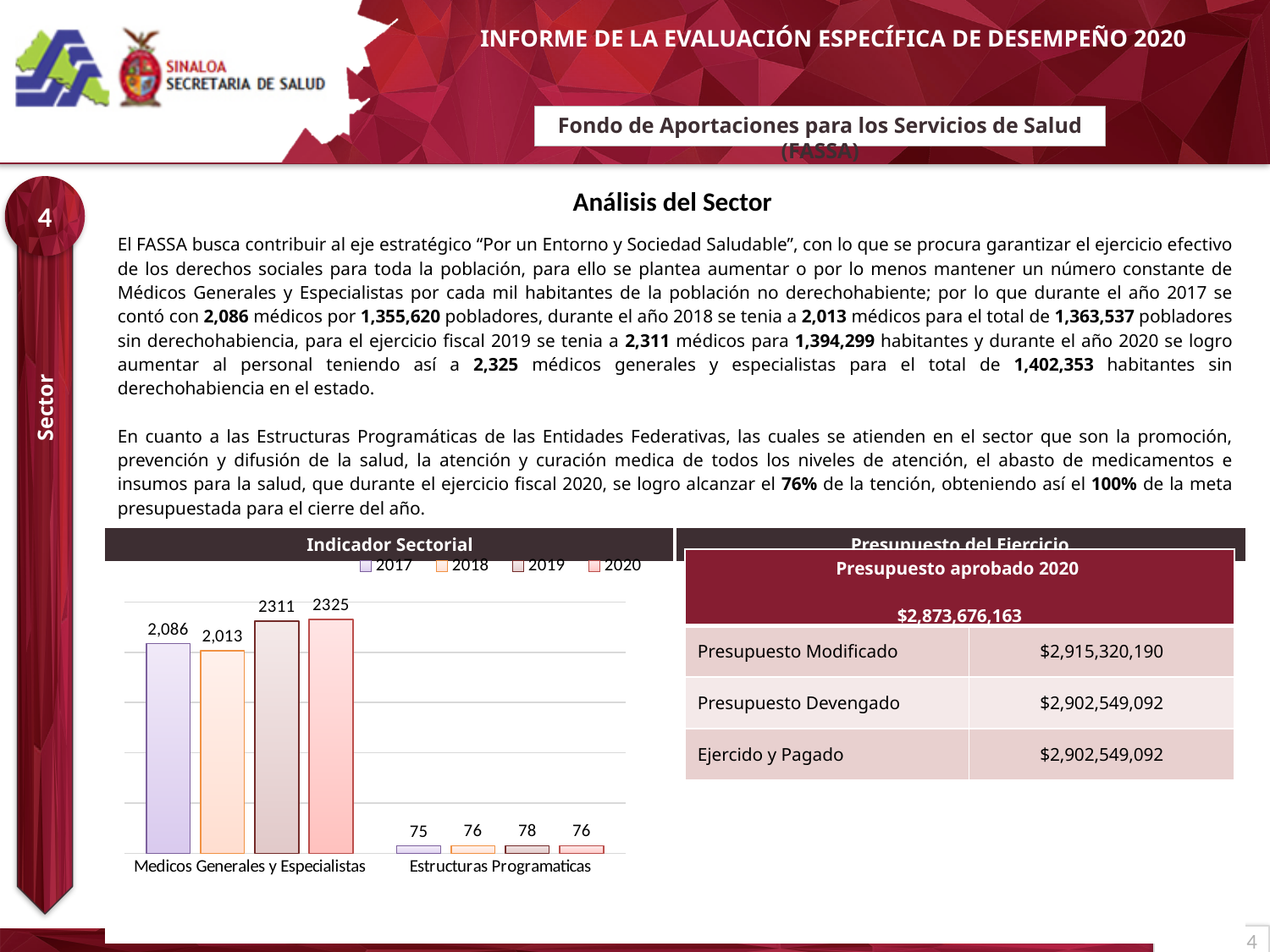
Which year has the highest value for Medicos Generales y Especialistas? 2020 How many series does the legend list? 4 What kind of chart is shown on the slide? Bar chart What is the value for Estructuras Programaticas in 2017? 75 What is the value for Estructuras Programaticas in 2019? 78 How many categories are shown on the x axis of the chart? 2 Which year has the highest value for Estructuras Programaticas? 2019 Which is larger for Medicos Generales y Especialistas, the 2017 value or the 2018 value? 2017 What is the value for Medicos Generales y Especialistas in 2017? 2,086 What is the value for Medicos Generales y Especialistas in 2020? 2325 Which year has the lowest value for Medicos Generales y Especialistas? 2018 What is the difference between the 2020 and 2019 values for Medicos Generales y Especialistas? 14